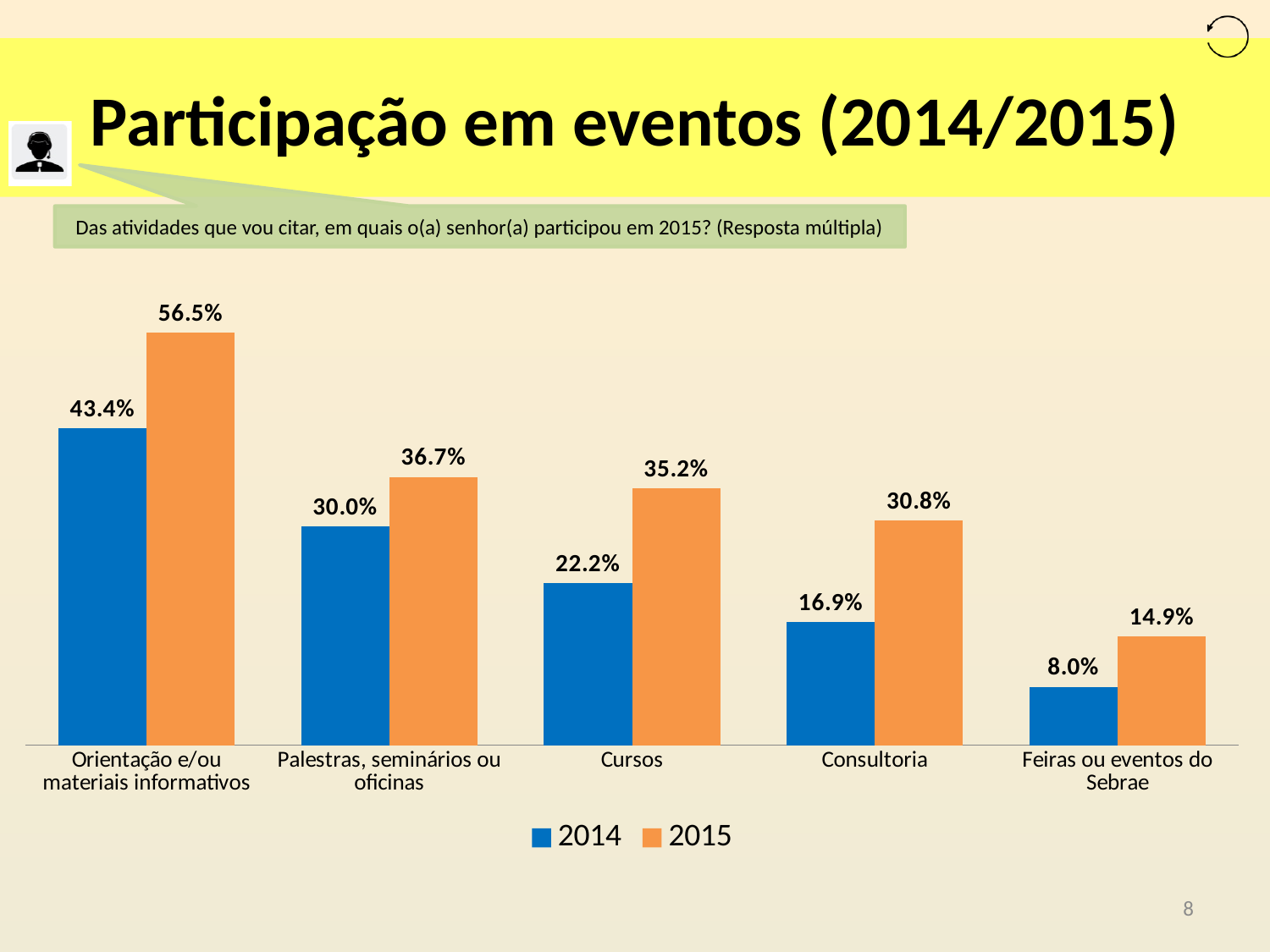
What is the 2015 value for Cursos? 35.2% What kind of chart is shown on the slide? Bar chart What is the difference between the 2015 and 2014 values for Orientação e/ou materiais informativos? 13.1% Which category has the lowest 2014 value? Feiras ou eventos do Sebrae What is the difference between the 2015 and 2014 values for Consultoria? 13.9% Which colour represents the 2015 series? Orange Which is larger: the 2014 value for Palestras, seminários ou oficinas or the 2015 value for Cursos? 2015 value for Cursos Which category has the highest 2015 value? Orientação e/ou materiais informativos How many categories are shown on the x axis? 5 How many series does the legend list? 2 What is the 2014 value for Consultoria? 16.9% What is the 2015 value for Feiras ou eventos do Sebrae? 14.9%